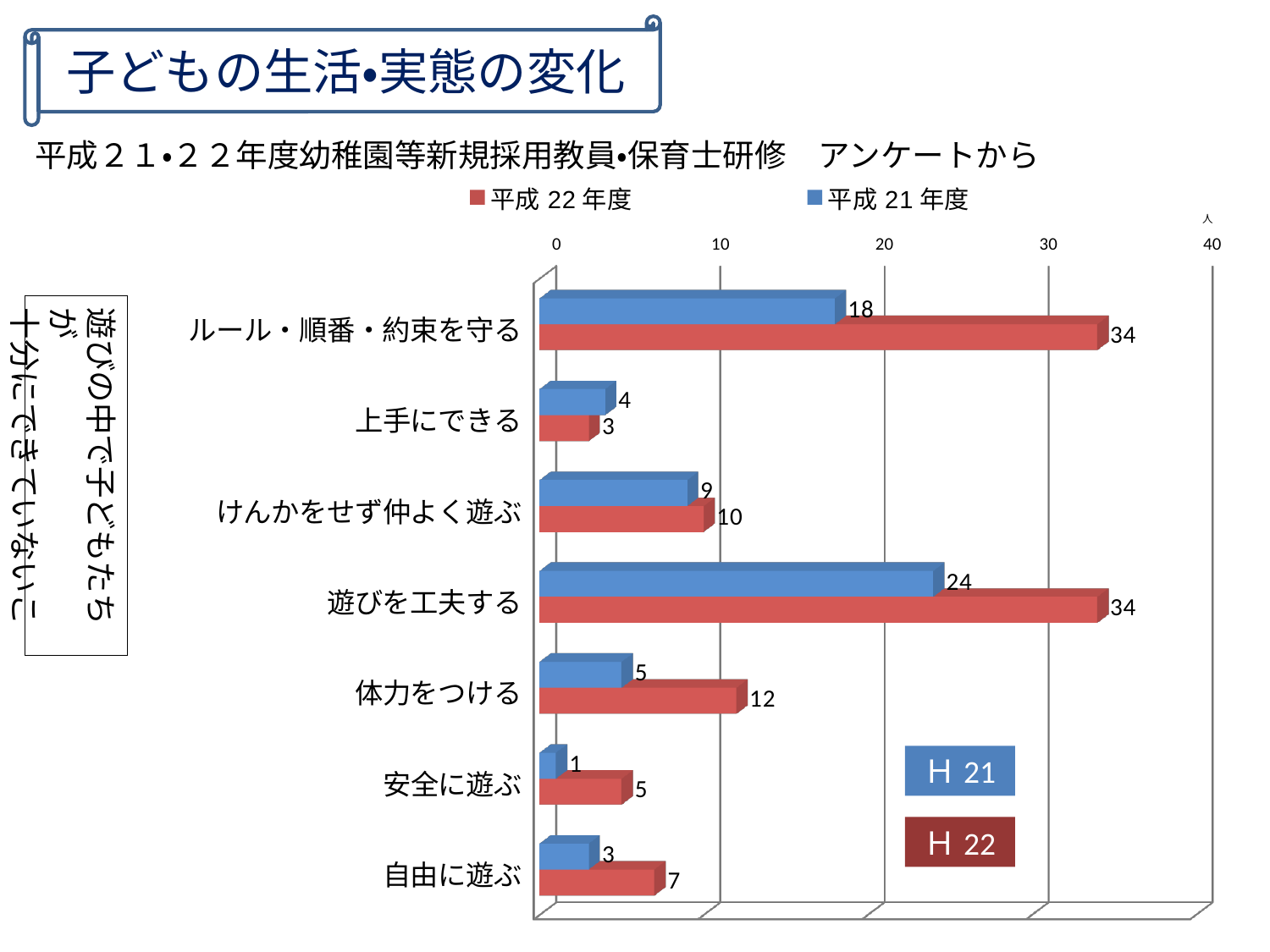
Which category has the highest value in the 平成 21 年度 series? 遊びを工夫する For 上手にできる, which series has the larger value, 平成 21 年度 or 平成 22 年度? 平成 21 年度 What is the value for 遊びを工夫する in the 平成 21 年度 series? 24 What is the value for ルール・順番・約束を守る in the 平成 22 年度 series? 34 Is the 平成 22 年度 value for 遊びを工夫する greater or less than 30? greater What is the difference between the 平成 22 年度 and 平成 21 年度 values for ルール・順番・約束を守る? 16 What kind of chart is shown on the slide? bar chart What is the value for 安全に遊ぶ in the 平成 21 年度 series? 1 How many categories are shown on the chart? 7 How many series does the legend list? 2 What is the value for 体力をつける in the 平成 22 年度 series? 12 Which category has the lowest value in the 平成 22 年度 series? 上手にできる